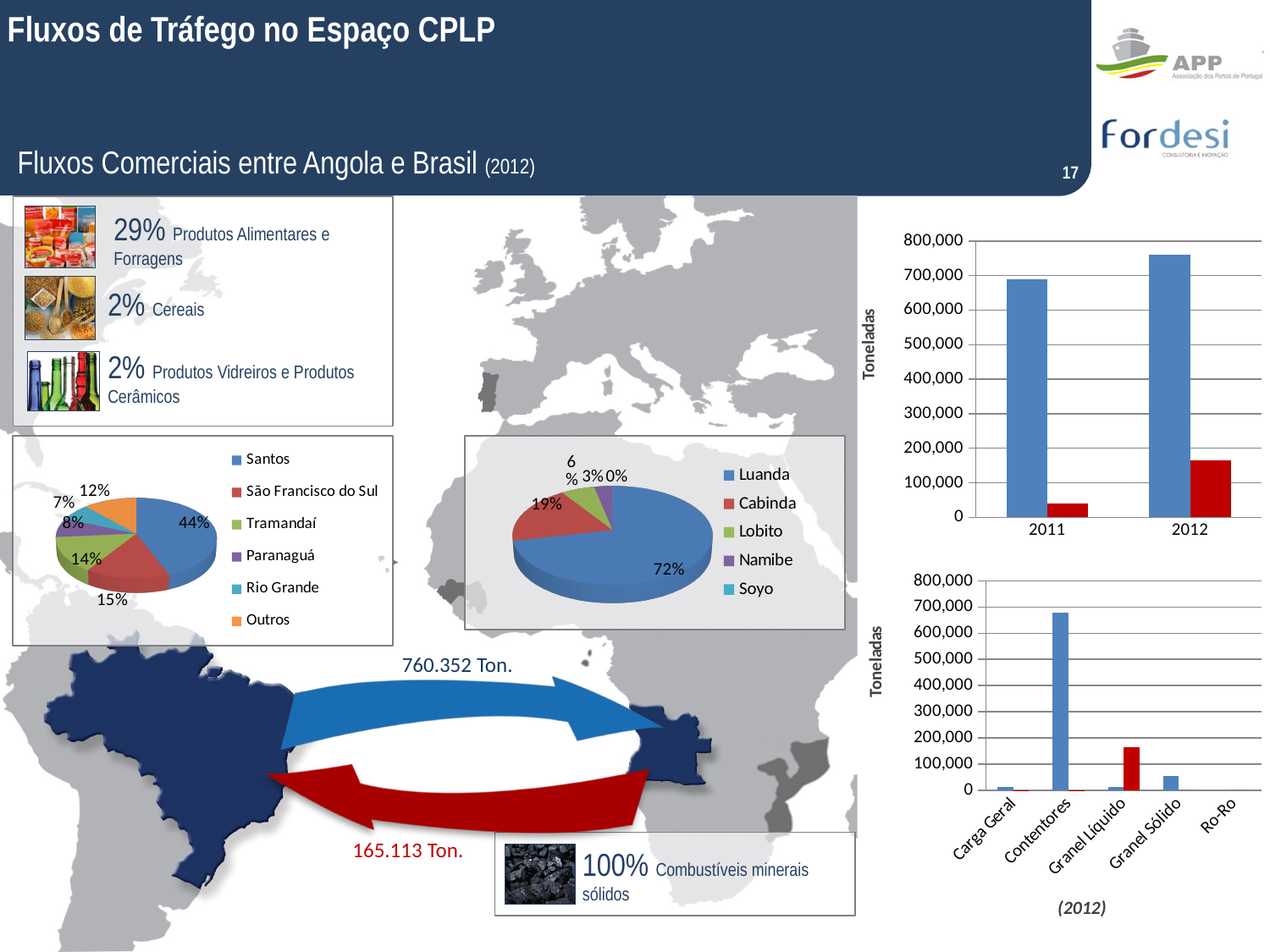
In the top-right bar chart, is the value of the red bar for 2011 greater or less than 100,000? less In the pie chart in the middle of the slide, which port has the smallest share? Soyo In the pie chart on the left of the slide, which port has the largest share? Santos In the pie chart in the middle of the slide, how many ports are listed in the legend? 5 In the pie chart in the middle of the slide, what share does Cabinda have? 19% In the pie chart on the left of the slide, which named port (excluding Outros) has the smallest share? Rio Grande In the top-right bar chart, is the value of the blue bar for 2012 greater or less than 700,000? greater In the pie chart on the left of the slide, what share does Santos have? 44% In the bottom-right bar chart, which category has the tallest blue bar? Contentores In the pie chart on the left of the slide, what is the difference between the shares of Santos and São Francisco do Sul? 29% In the pie chart on the left of the slide, how many slices are listed in the legend? 6 In the pie chart in the middle of the slide, what share does Luanda have? 72%